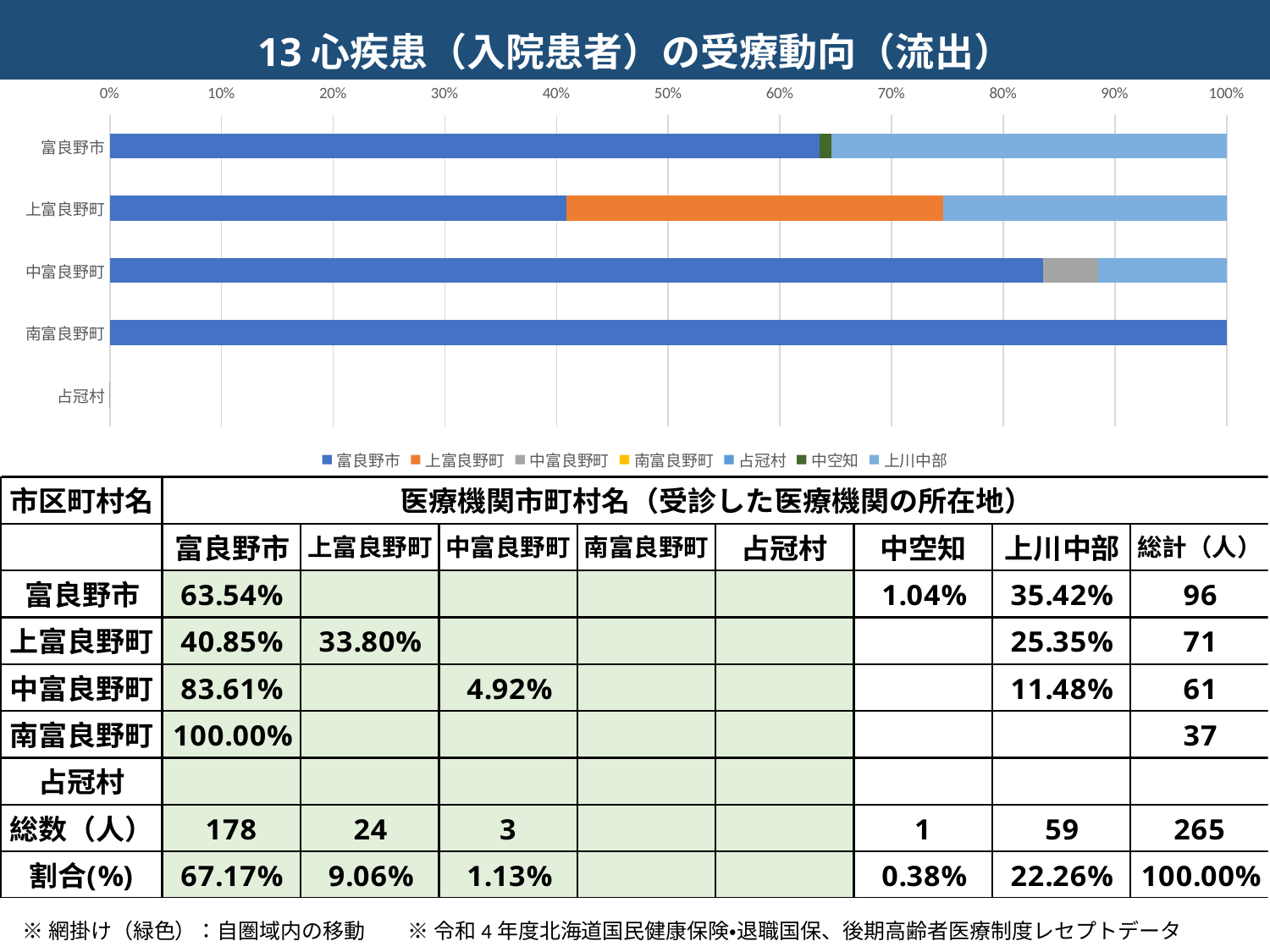
How many municipalities are listed on the vertical axis of the chart? 5 What share of 南富良野町 inpatients received care in 富良野市? 100.00% How many series does the chart legend list? 7 What is the difference between the 富良野市 share for 中富良野町 (83.61%) and for 富良野市 (63.54%)? 20.07% Which is larger: the 上川中部 share for 富良野市 or the 上川中部 share for 中富良野町? 富良野市 Is the 富良野市 share of the 上富良野町 bar greater or less than 50%? less Is the 富良野市 share of the 中富良野町 bar greater or less than 80%? greater Which municipality has the largest 富良野市 segment in its bar? 南富良野町 What kind of chart is shown on the slide? stacked bar chart What share of 富良野市 inpatients with heart disease received care in 富良野市? 63.54% What share of 上富良野町 inpatients received care in 上富良野町? 33.80% What share of 中富良野町 inpatients received care in 上川中部? 11.48%